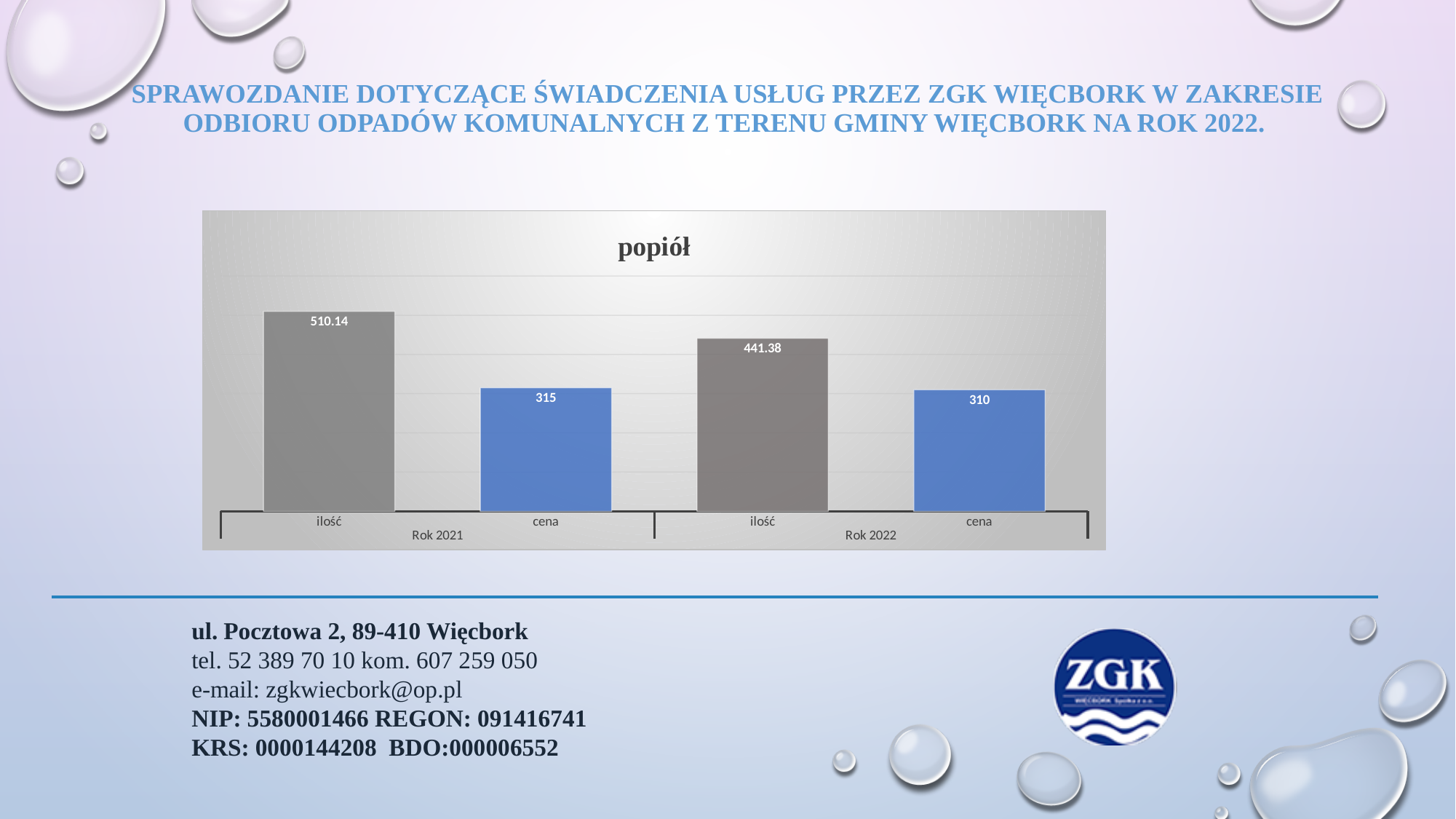
What is the title of the chart on the slide? popiół Which is larger: ilość for Rok 2021 or ilość for Rok 2022? ilość for Rok 2021 What is the value of ilość for Rok 2022 in the popiół chart? 441.38 Which bar has the lowest value in the popiół chart? cena, Rok 2022 How many bars are plotted in the popiół chart? 4 What is the difference between cena for Rok 2021 and cena for Rok 2022? 5 Which bar has the highest value in the popiół chart? ilość, Rok 2021 What kind of chart is shown on the slide? bar chart What is the difference between ilość for Rok 2021 and ilość for Rok 2022? 68.76 What is the value of cena for Rok 2021 in the popiół chart? 315 What is the value of ilość for Rok 2021 in the popiół chart? 510.14 What is the value of cena for Rok 2022 in the popiół chart? 310